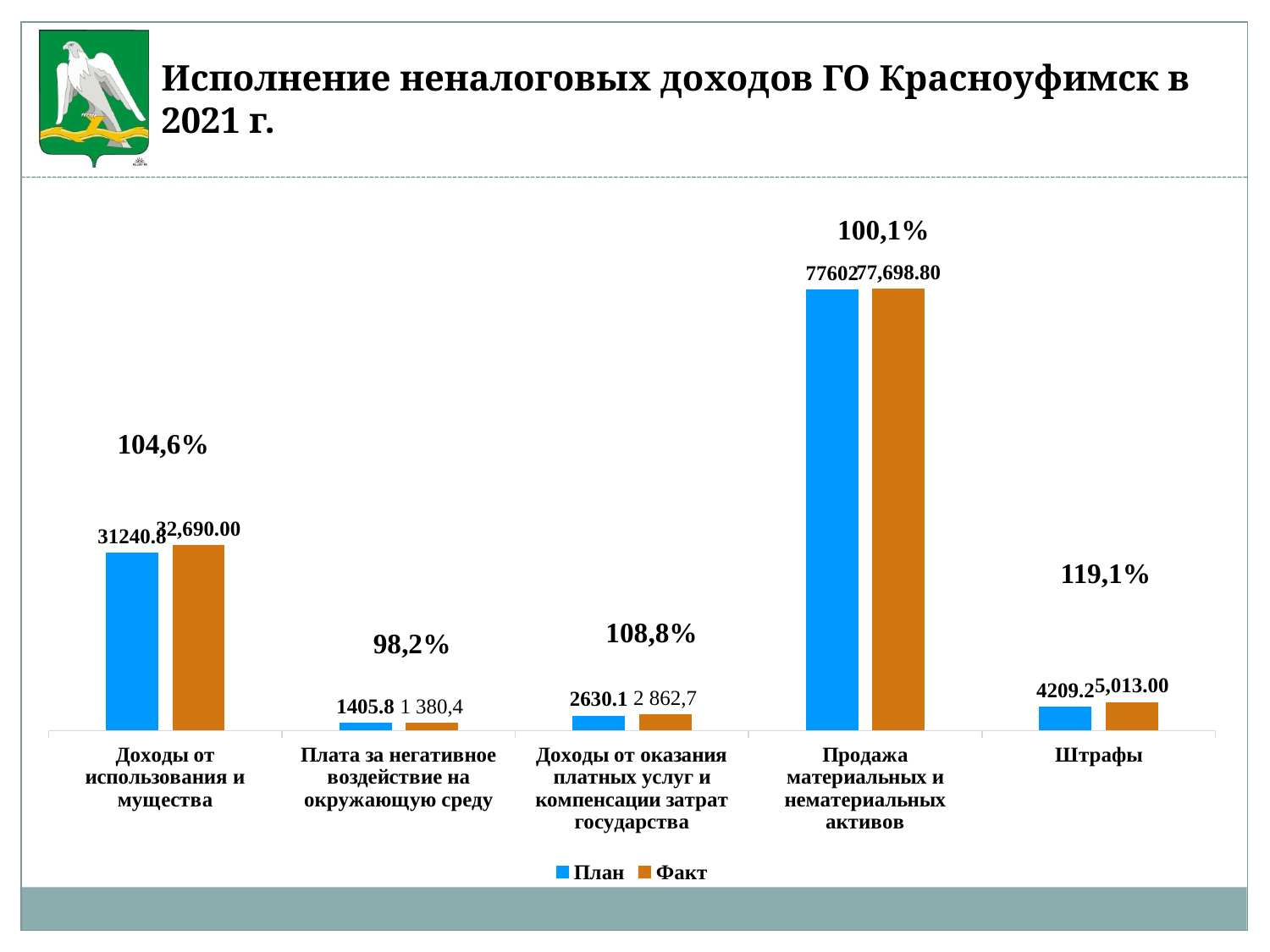
Which category has the lowest План value? Плата за негативное воздействие на окружающую среду How many series does the legend list? 2 What kind of chart is shown on the slide? bar chart Which category has the highest Факт value? Продажа материальных и нематериальных активов What is the План value for Плата за негативное воздействие на окружающую среду? 1405.8 What percentage is shown above the bars for Штрафы? 119,1% What is the Факт value for Штрафы? 5,013.00 What are the two entries in the legend? План, Факт What percentage is shown above the bars for Плата за негативное воздействие на окружающую среду? 98,2% What is the Факт value for Доходы от оказания платных услуг и компенсации затрат государства? 2 862,7 How many categories are shown on the x axis? 5 For Штрафы, which is larger: План or Факт? Факт